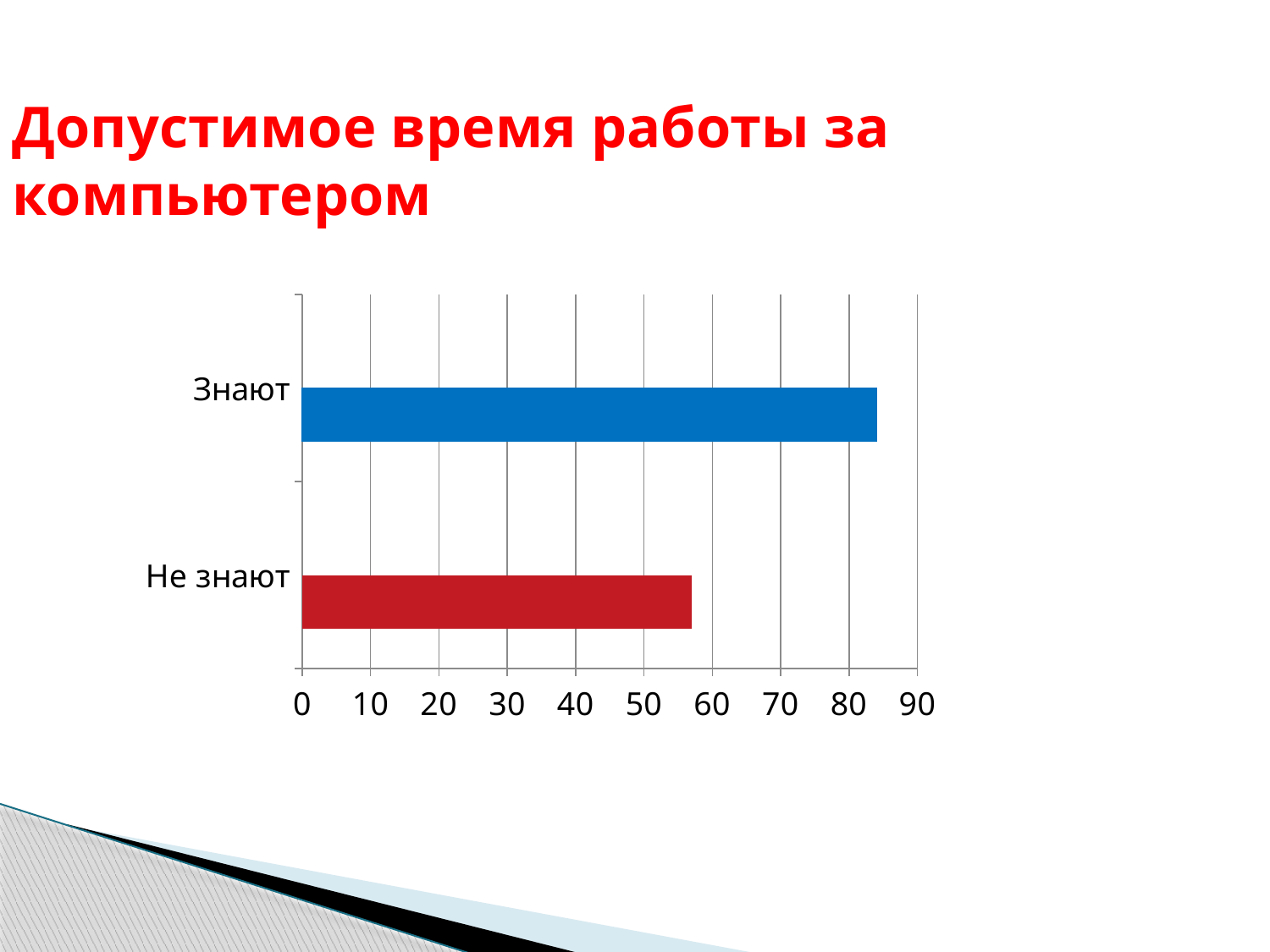
Which category has the highest value? Знают How many categories does the chart show? 2 Is the value for Не знают greater or less than 60? less Is the value for Не знают greater or less than 50? greater What colour is the bar for Не знают? red What is the title shown above the chart on the slide? Допустимое время работы за компьютером Is the value for Знают greater or less than 80? greater Which category has the lowest value? Не знают What kind of chart is shown on the slide? bar chart Which is larger, the value for Знают or the value for Не знают? Знают